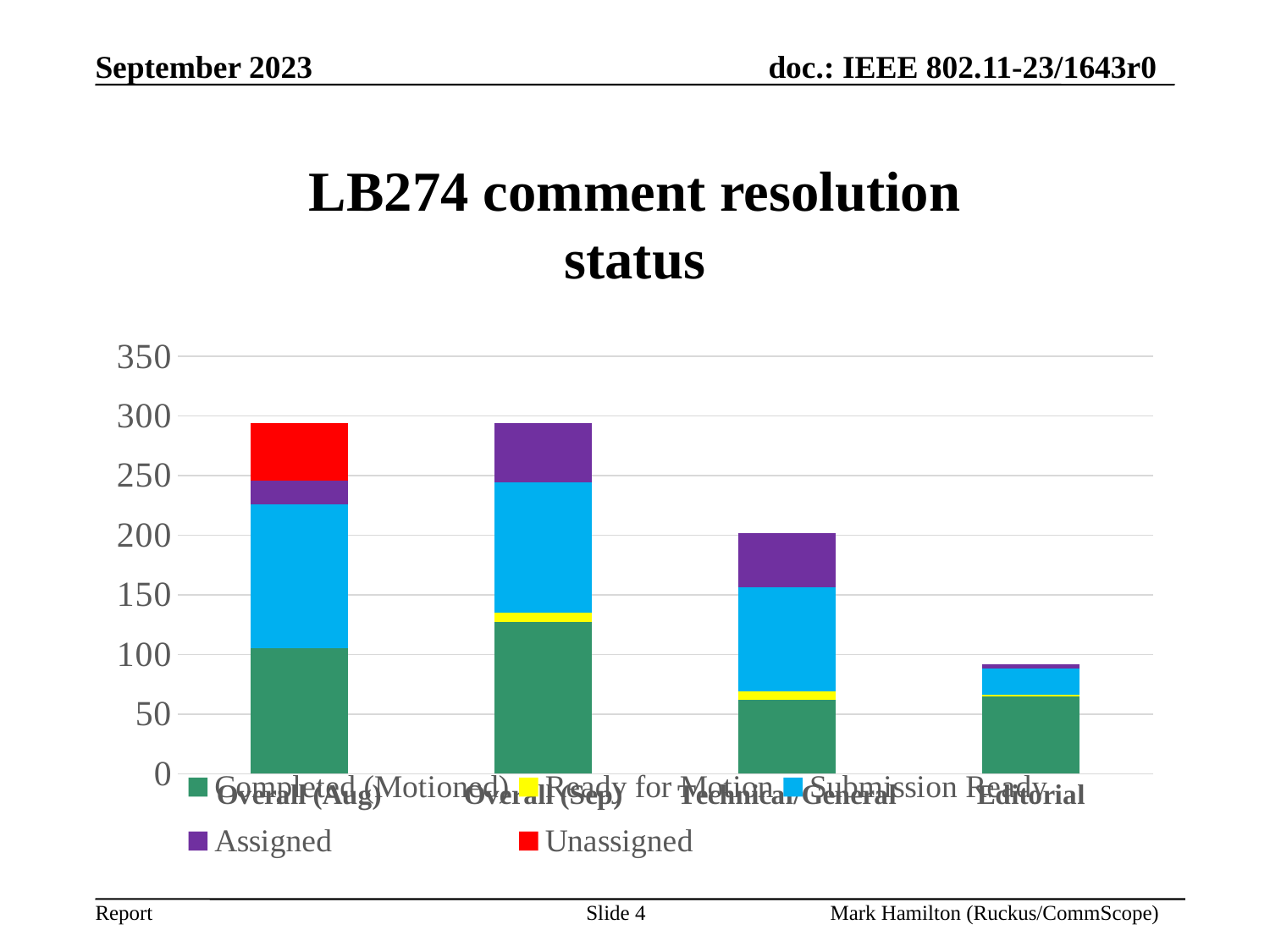
Is the total for Editorial greater or less than 100? less Which has the larger total, Technical/General or Editorial? Technical/General Which category has the lowest total bar height? Editorial Is the Completed (Motioned) value for Overall (Sep) greater or less than 100? greater What kind of chart is shown on the slide? Stacked bar chart How many series does the chart's legend list? 5 Is the total for Technical/General greater or less than 150? greater How many categories are shown on the x axis of the chart? 4 Which category is the only one with an Unassigned (red) segment? Overall (Aug) What is the title of the chart? LB274 comment resolution status